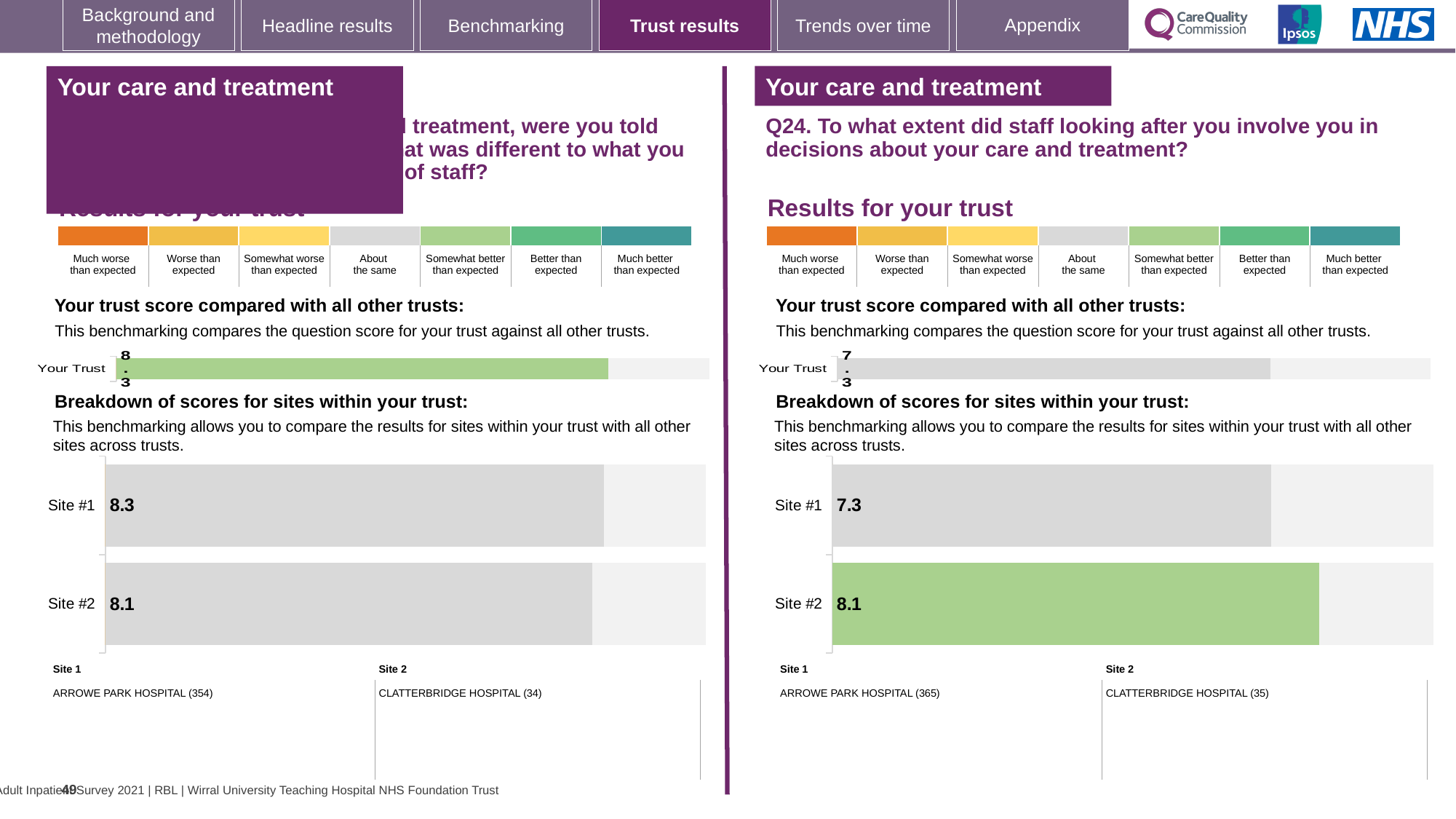
On the right panel (Q24) 'Breakdown of scores for sites within your trust' chart, what is the score for Site #1? 7.3 On the right panel (Q24) site breakdown chart, which site has the higher score? Site #2 On the left panel's site breakdown chart, what is the difference between the Site #1 and Site #2 scores? 0.2 On the right panel (Q24) site breakdown chart, which site's bar is coloured green? Site #2 On the right panel (Q24) 'Your trust score compared with all other trusts' chart, what is the score for Your Trust? 7.3 On the left panel's 'Breakdown of scores for sites within your trust' chart, what is the score for Site #1? 8.3 On the left panel's 'Your trust score compared with all other trusts' chart, what is the score for Your Trust? 8.3 On the right panel (Q24) 'Breakdown of scores for sites within your trust' chart, what is the score for Site #2? 8.1 What type of chart is used for the site breakdown on the left panel? Bar chart On the right panel (Q24) site breakdown chart, what is the difference between the Site #2 and Site #1 scores? 0.8 How many sites are shown in the right panel (Q24) site breakdown chart? 2 On the left panel's 'Breakdown of scores for sites within your trust' chart, what is the score for Site #2? 8.1